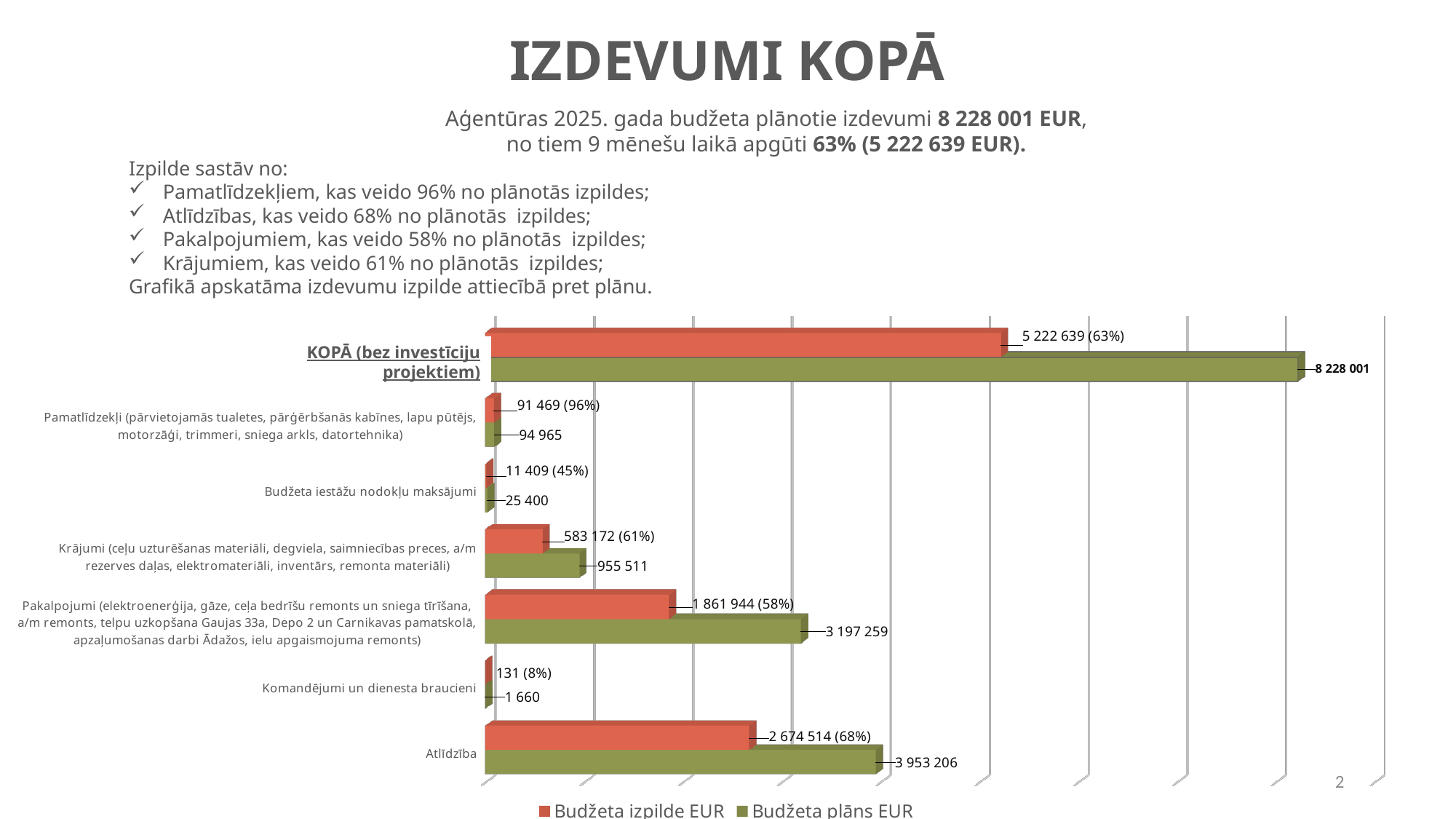
What is the Budžeta plāns EUR value for Atlīdzība? 3 953 206 How many series does the chart legend list? 2 How many categories are plotted on the chart? 7 Excluding the KOPĀ total, which category has the lowest Budžeta izpilde EUR value? Komandējumi un dienesta braucieni Which series is shown in red on the chart? Budžeta izpilde EUR What kind of chart is shown on the slide? bar chart Excluding the KOPĀ total, which category has the highest Budžeta plāns EUR value? Atlīdzība What is the Budžeta plāns EUR value for Krājumi? 955 511 What is the Budžeta izpilde EUR value for Pakalpojumi? 1 861 944 What is the difference between the Budžeta plāns EUR and Budžeta izpilde EUR values for Pakalpojumi? 1 335 315 What percentage of the plan is shown next to the Budžeta izpilde EUR bar for Budžeta iestāžu nodokļu maksājumi? 45% Which is larger: the Budžeta izpilde EUR value for Atlīdzība or for Pakalpojumi? Atlīdzība